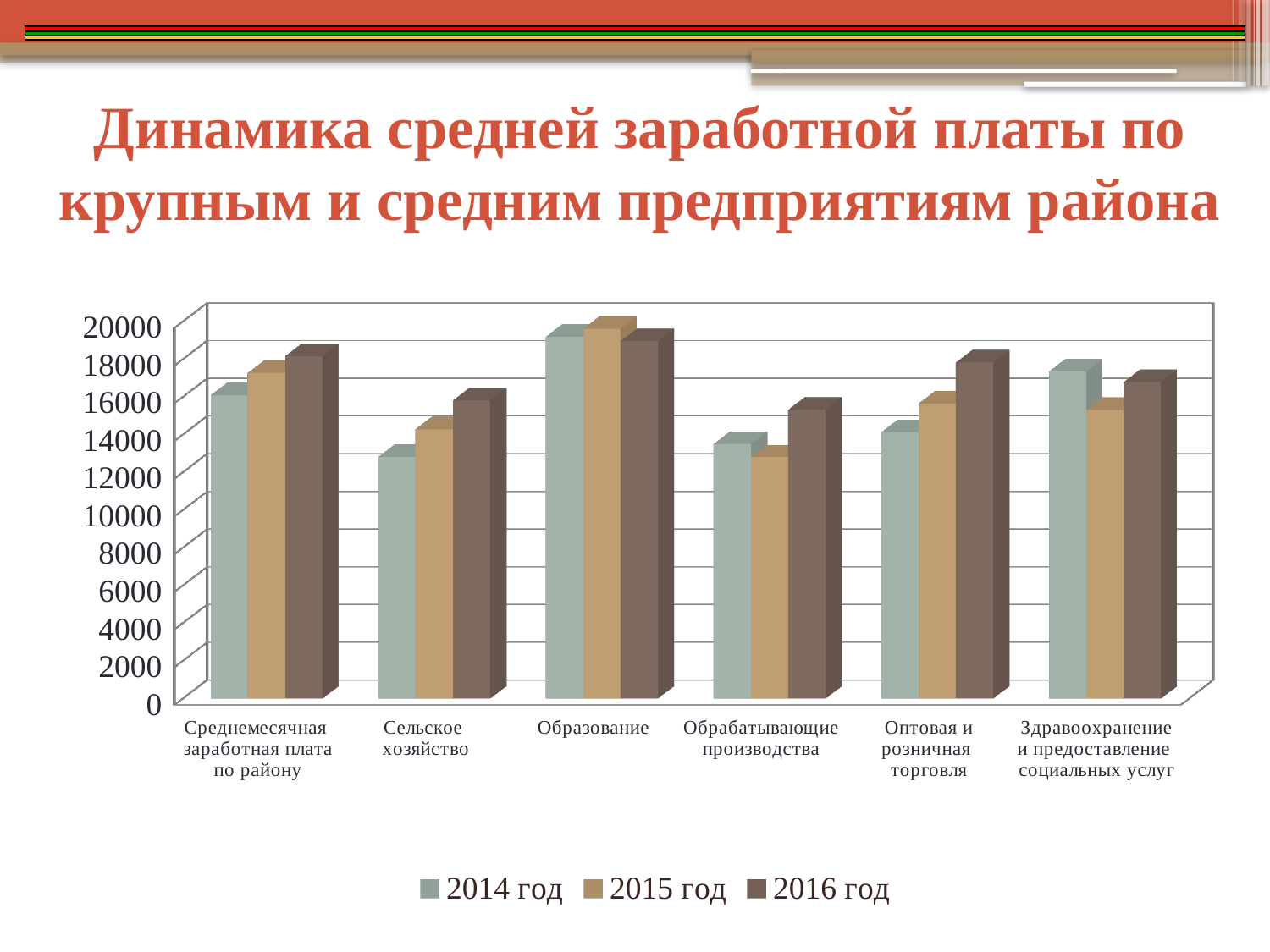
Which category has the highest value for 2015 год? Образование What kind of chart is shown on the slide? bar chart Which category has the lowest value for 2014 год? Сельское хозяйство How many series does the legend list? 3 Is the value for Оптовая и розничная торговля in 2016 год greater or less than 16000? greater How many categories are shown along the x axis? 6 What are the entries listed in the legend? 2014 год, 2015 год, 2016 год Is the value for Сельское хозяйство in 2014 год greater or less than 14000? less For Здравоохранение и предоставление социальных услуг, which is larger: the value for 2014 год or 2015 год? 2014 год Which category has the lowest value for 2015 год? Обрабатывающие производства Is the value for Образование in 2015 год greater or less than 18000? greater Do the values for Сельское хозяйство rise or fall from 2014 год to 2016 год? rise